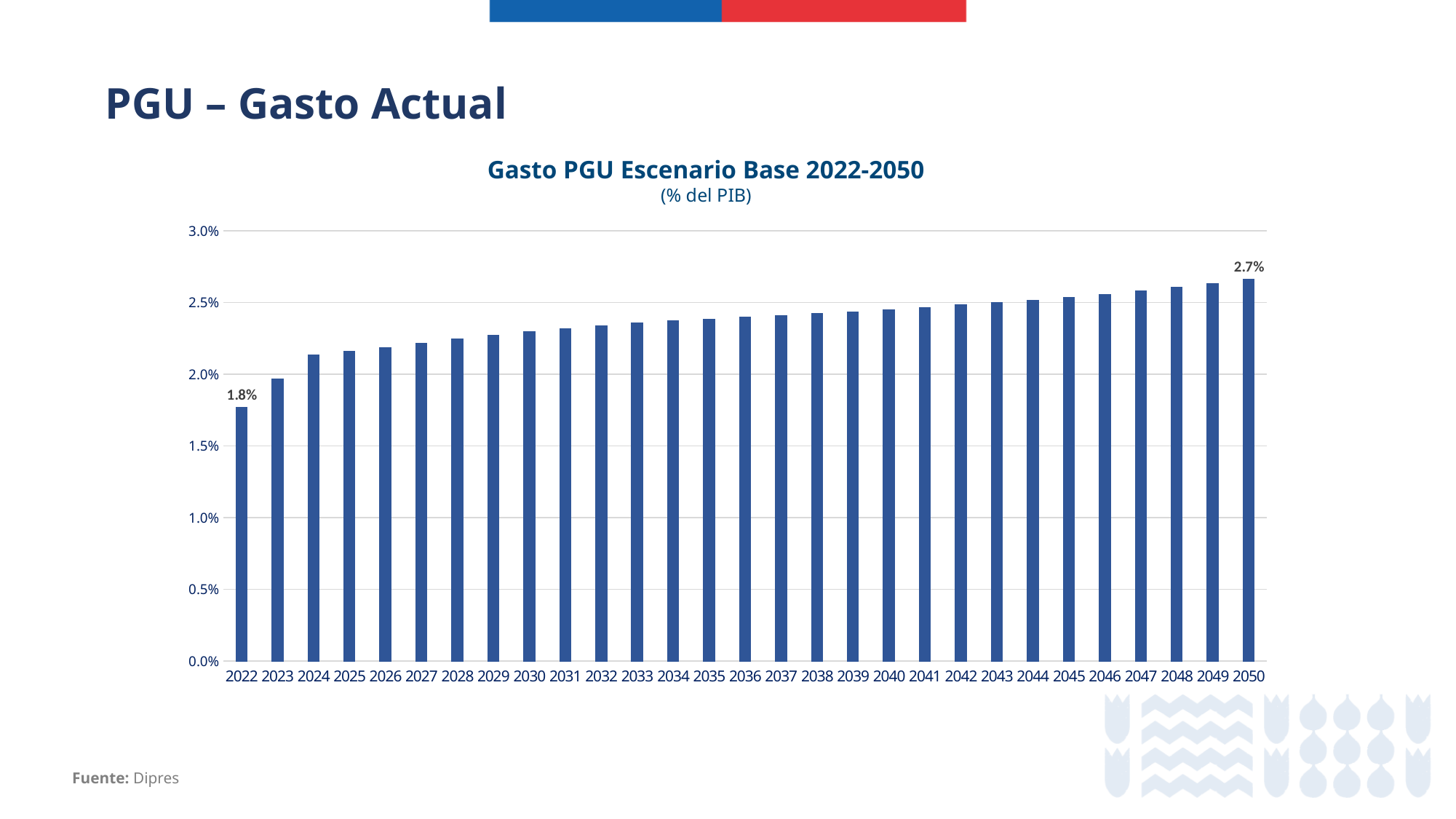
Which year has the highest value in the chart? 2050 Which year has the lowest value in the chart? 2022 Do the values rise or fall from 2022 to 2050? Rise What is the value for 2050 in the Gasto PGU Escenario Base 2022-2050 chart? 2.7% What is the difference between the 2050 value and the 2022 value? 0.9% Which is larger, the value for 2030 or the value for 2045? 2045 How many years are shown on the x axis of the chart? 29 Is the value for 2040 greater or less than 2.0%? greater What unit is given in the chart's subtitle? % del PIB What kind of chart is shown on the slide? Bar chart What is the value for 2022 in the Gasto PGU Escenario Base 2022-2050 chart? 1.8%